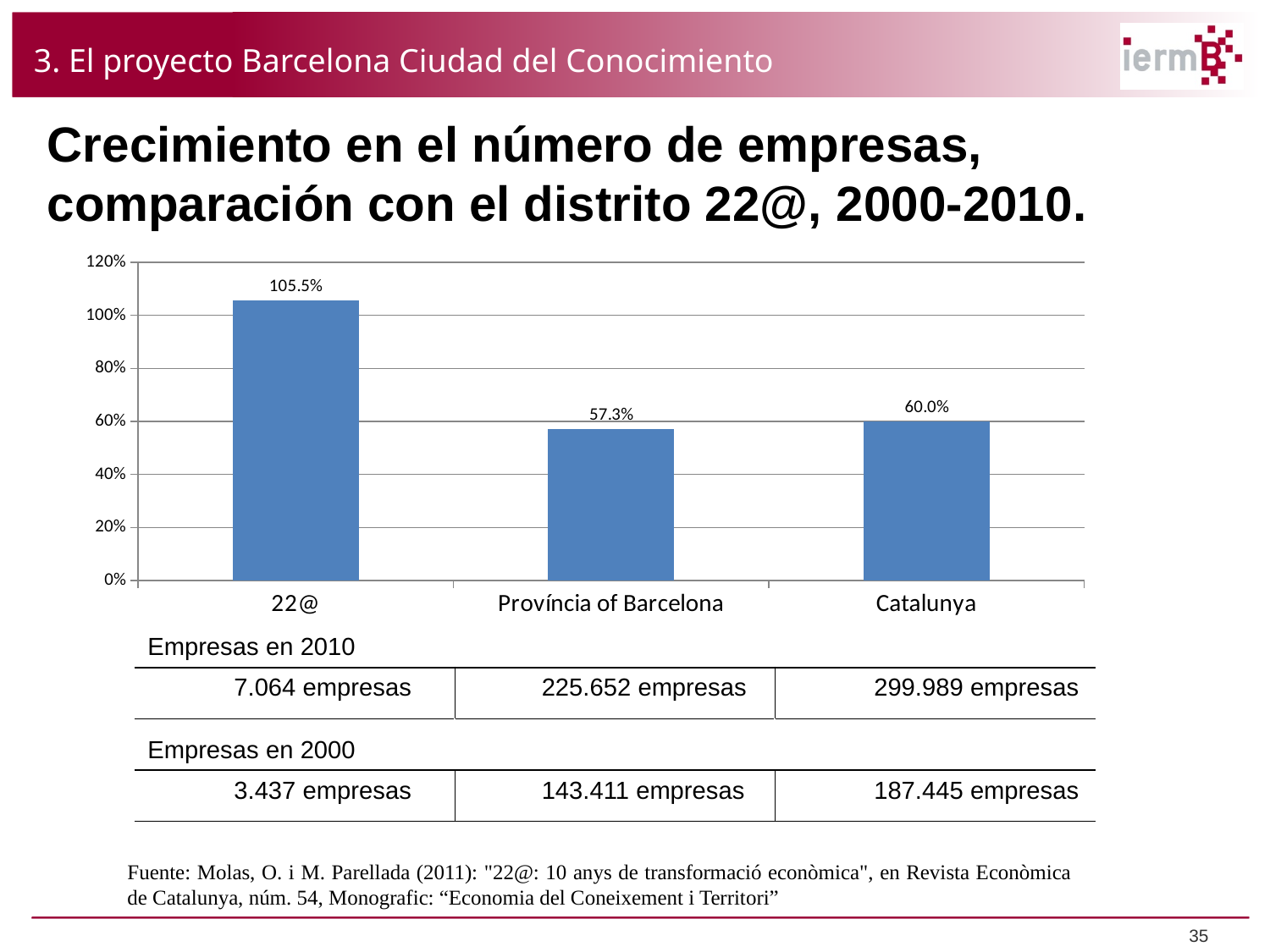
What is the difference between the growth values for 22@ and Catalunya? 45.5% Which category has the highest growth value? 22@ How many categories are shown on the x axis of the chart? 3 What is the growth value shown for Catalunya? 60.0% Is the value for Província of Barcelona greater or less than 60%? less What is the difference between the growth values for Catalunya and Província of Barcelona? 2.7% What is the growth value shown for Província of Barcelona? 57.3% What is the growth value shown for 22@? 105.5% Which category has the lowest growth value? Província of Barcelona Which is larger, the growth value for 22@ or for Província of Barcelona? 22@ What is the highest value labelled on the vertical axis of the chart? 120% What kind of chart is shown on the slide? bar chart